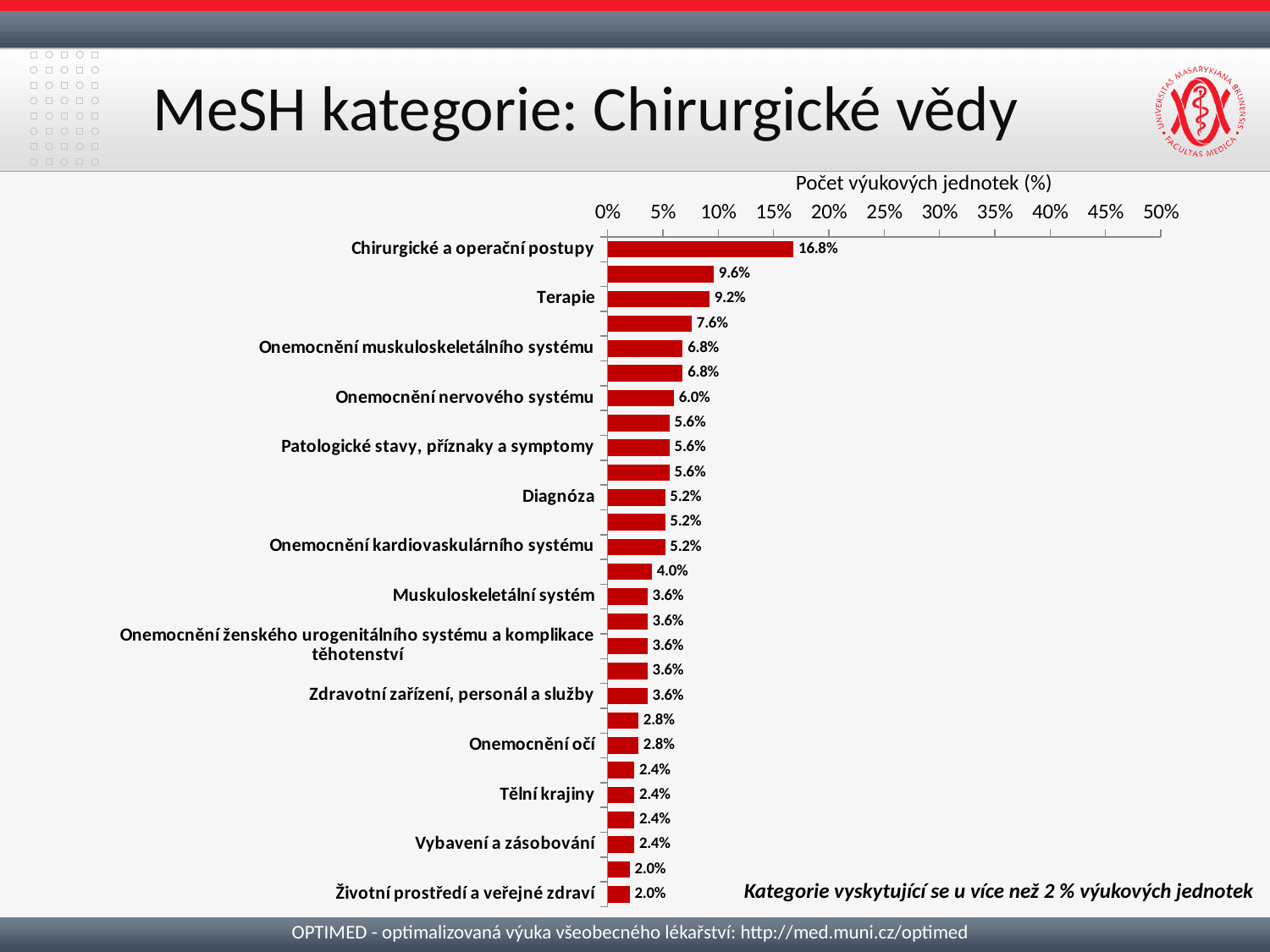
What is the difference between the values for Chirurgické a operační postupy and Terapie? 7.6% Which category has the highest value? Chirurgické a operační postupy Is the value for Chirurgické a operační postupy greater or less than 15%? greater What is the value for Chirurgické a operační postupy? 16.8% What is the value for Onemocnění očí? 2.8% Which is larger, the value for Terapie or the value for Diagnóza? Terapie What is the title of the horizontal axis? Počet výukových jednotek (%) What is the value for Diagnóza? 5.2% What kind of chart is shown on the slide? bar chart What is the value for Onemocnění nervového systému? 6.0% What is the value for Terapie? 9.2% What is the value for Životní prostředí a veřejné zdraví? 2.0%